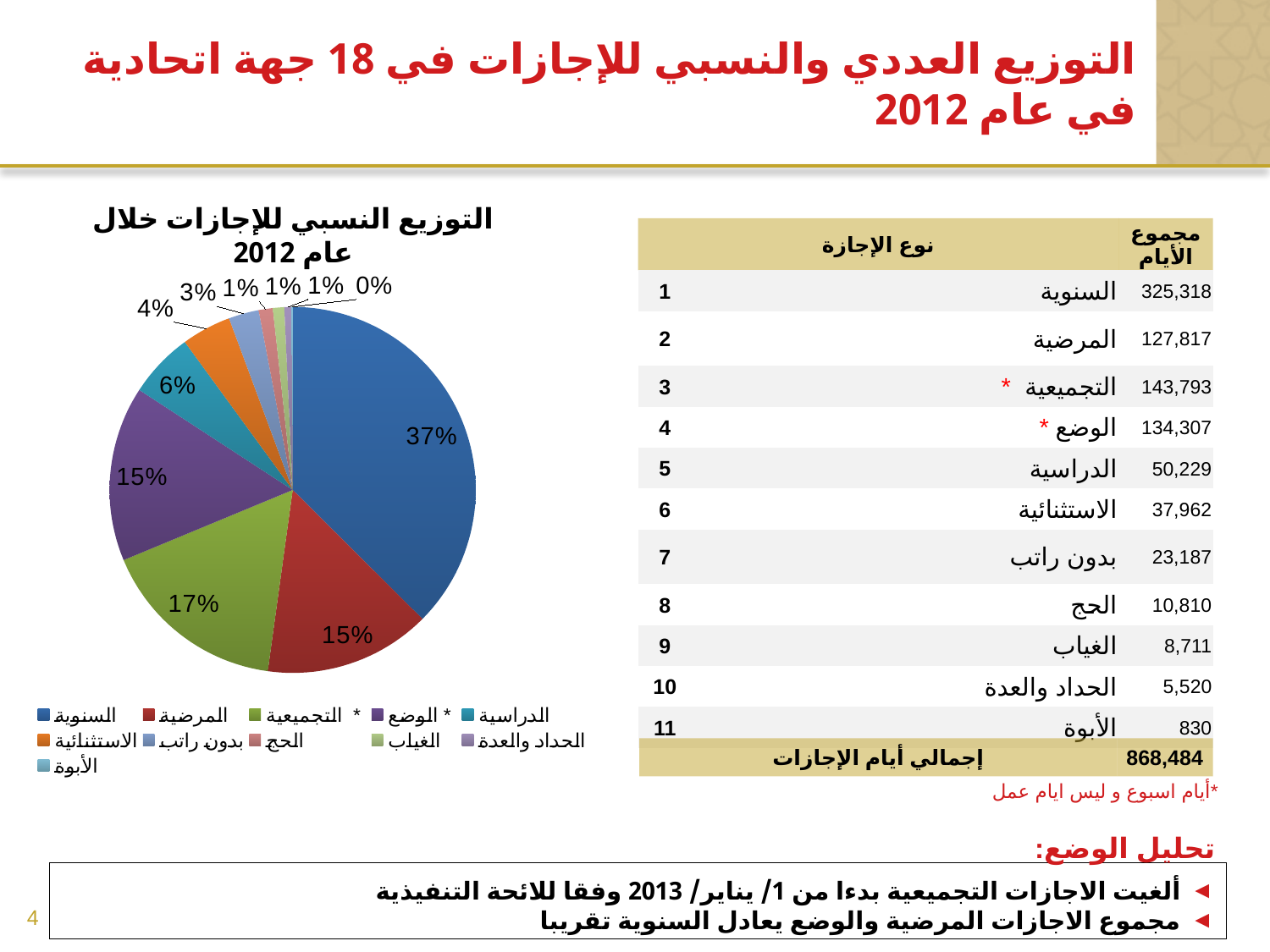
What is the difference in percentage points between the السنوية slice and the التجميعية slice? 20% How many categories does the pie chart's legend list? 11 What share of the pie does الاستثنائية represent? 4% What share of the pie does الدراسية represent? 6% Which category has the smallest slice of the pie? الأبوة What is the title of the pie chart? التوزيع النسبي للإجازات خلال عام 2012 What share of the pie does المرضية represent? 15% What kind of chart is shown on the slide? pie chart Which category has the largest slice of the pie? السنوية Which slice is larger, التجميعية or الدراسية? التجميعية